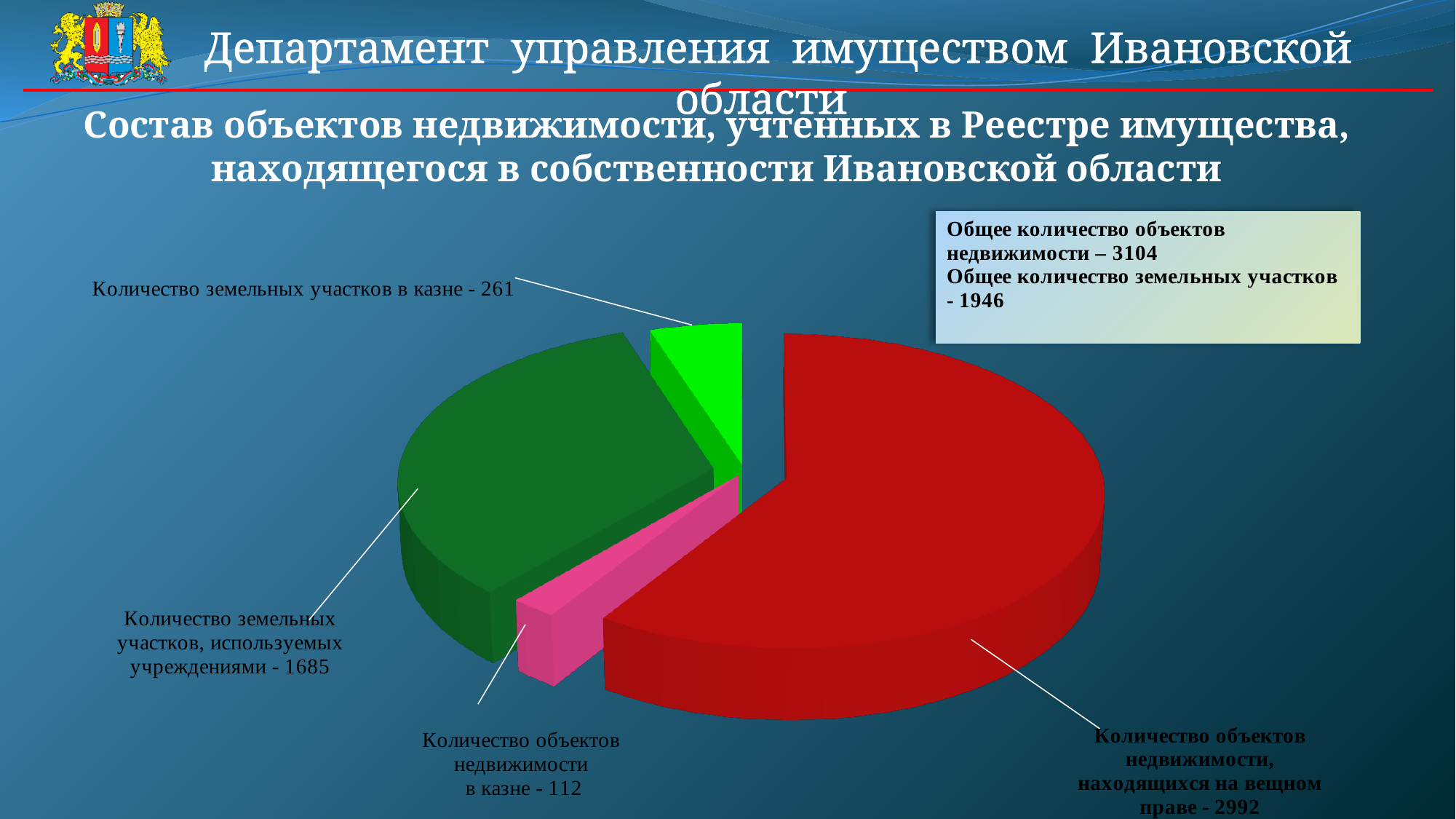
What is the value for "Количество объектов недвижимости в казне"? 112 What is the value for "Количество земельных участков в казне"? 261 What type of chart is shown on the slide? Pie chart Which category has the largest slice of the pie? Количество объектов недвижимости, находящихся на вещном праве What is the total of all four values shown in the pie chart? 5050 What is the difference between the number of real estate objects on property right (вещное право) and the number of land plots used by institutions? 1307 How many slices does the pie chart have? 4 What is the value for "Количество земельных участков, используемых учреждениями"? 1685 Which category has the smallest slice of the pie? Количество объектов недвижимости в казне According to the text box on the slide, what is the total number of land plots (земельных участков)? 1946 What is the value for "Количество объектов недвижимости, находящихся на вещном праве"? 2992 Which is larger: the number of land plots in the treasury (в казне) or the number of real estate objects in the treasury? Количество земельных участков в казне